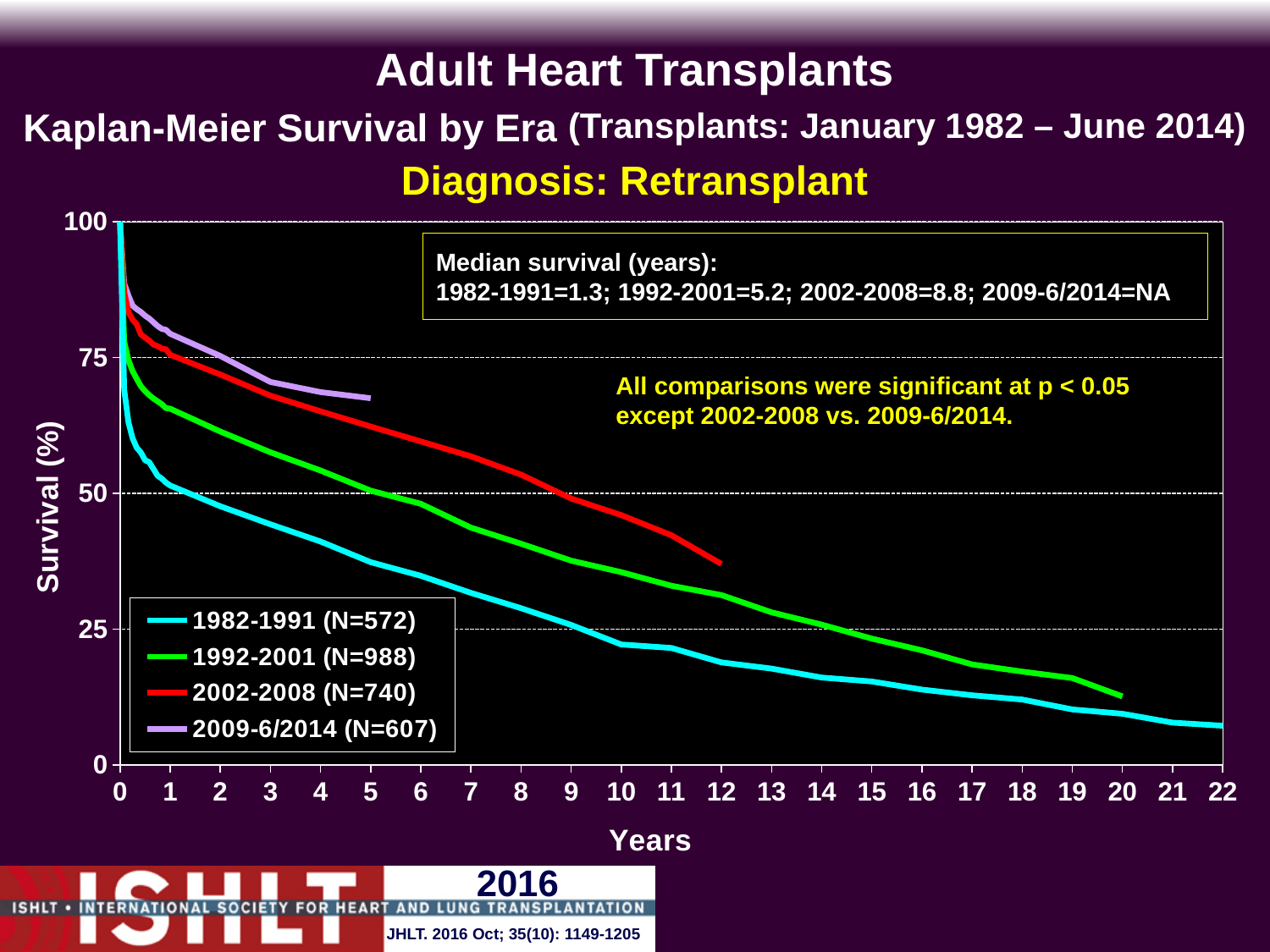
At 5 years, which era has higher survival: 1992-2001 or 2002-2008? 2002-2008 What kind of chart is shown on the slide? Line chart How many eras (series) does the legend list? 4 What is the difference in median survival (years) between the 2002-2008 era and the 1992-2001 era? 3.6 Which era has the highest survival at 2 years? 2009-6/2014 Do the survival curves rise or fall as years since transplant increase? Fall Is the survival for the 1982-1991 era at 5 years greater or less than 50? less Is the survival for the 2002-2008 era at 5 years greater or less than 50? greater Which era has the lowest survival at 2 years? 1982-1991 What is the N for the 1982-1991 era shown in the legend? 572 What is the median survival in years for the 2002-2008 era? 8.8 Is the survival for the 2009-6/2014 era at 3 years greater or less than 75? less